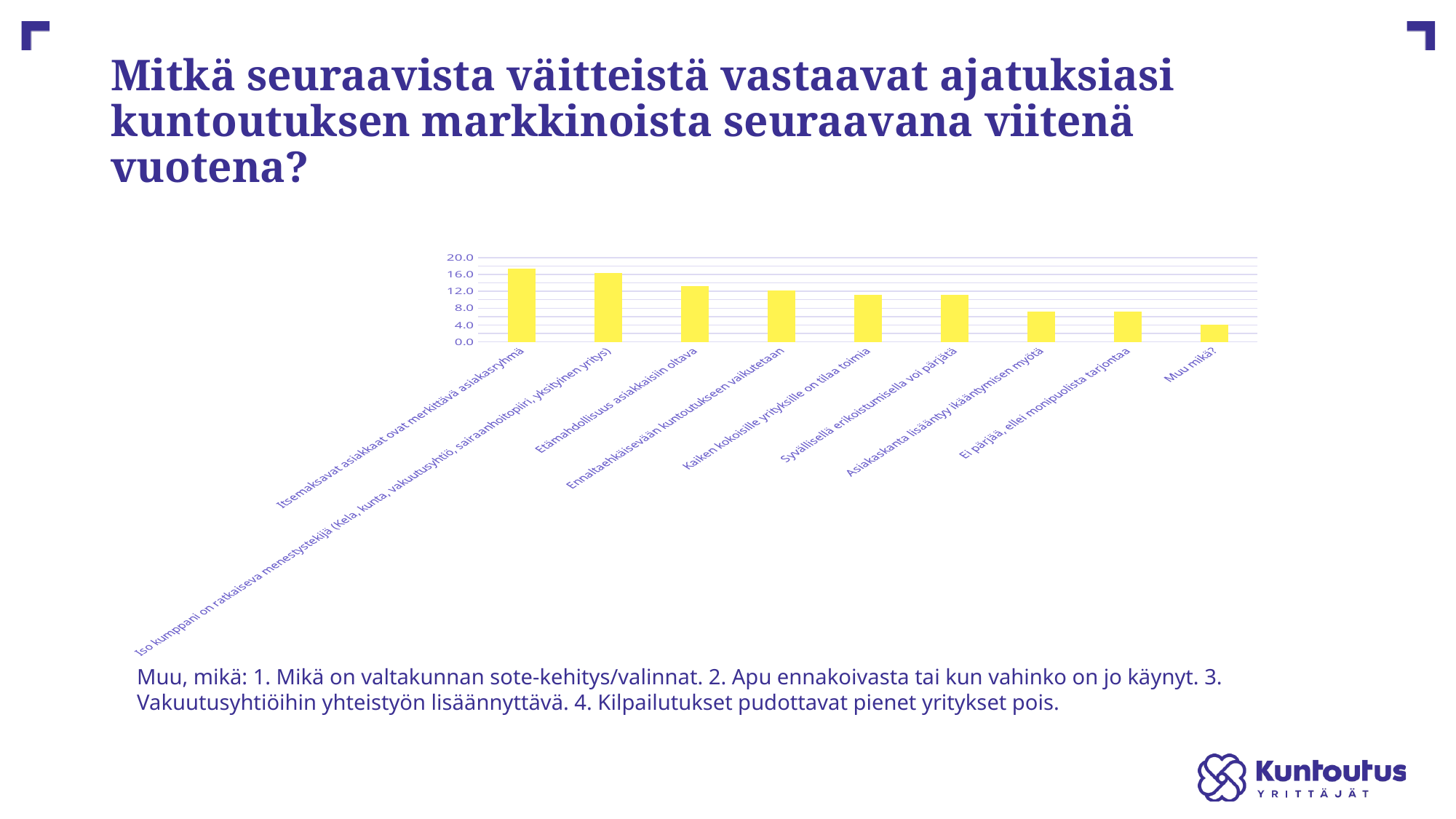
What is the highest value shown on the chart's vertical axis? 20.0 What kind of chart is shown on the slide? bar chart Is the value for "Muu mikä?" greater or less than 8.0? less Which has a larger value: "Muu mikä?" or "Kaiken kokoisille yrityksille on tilaa toimia"? Kaiken kokoisille yrityksille on tilaa toimia Which category has the highest value in the chart? Itsemaksavat asiakkaat ovat merkittävä asiakasryhmä Do the bar values generally rise or fall from left to right along the x axis? fall Is the value for "Asiakaskanta lisääntyy ikääntymisen myötä" greater or less than 12.0? less How many categories (bars) does the chart show? 9 Which has a larger value: "Etämahdollisuus asiakkaisiin oltava" or "Ei pärjää, ellei monipuolista tarjontaa"? Etämahdollisuus asiakkaisiin oltava Is the value for "Etämahdollisuus asiakkaisiin oltava" greater or less than 8.0? greater Which category has the lowest value in the chart? Muu mikä?